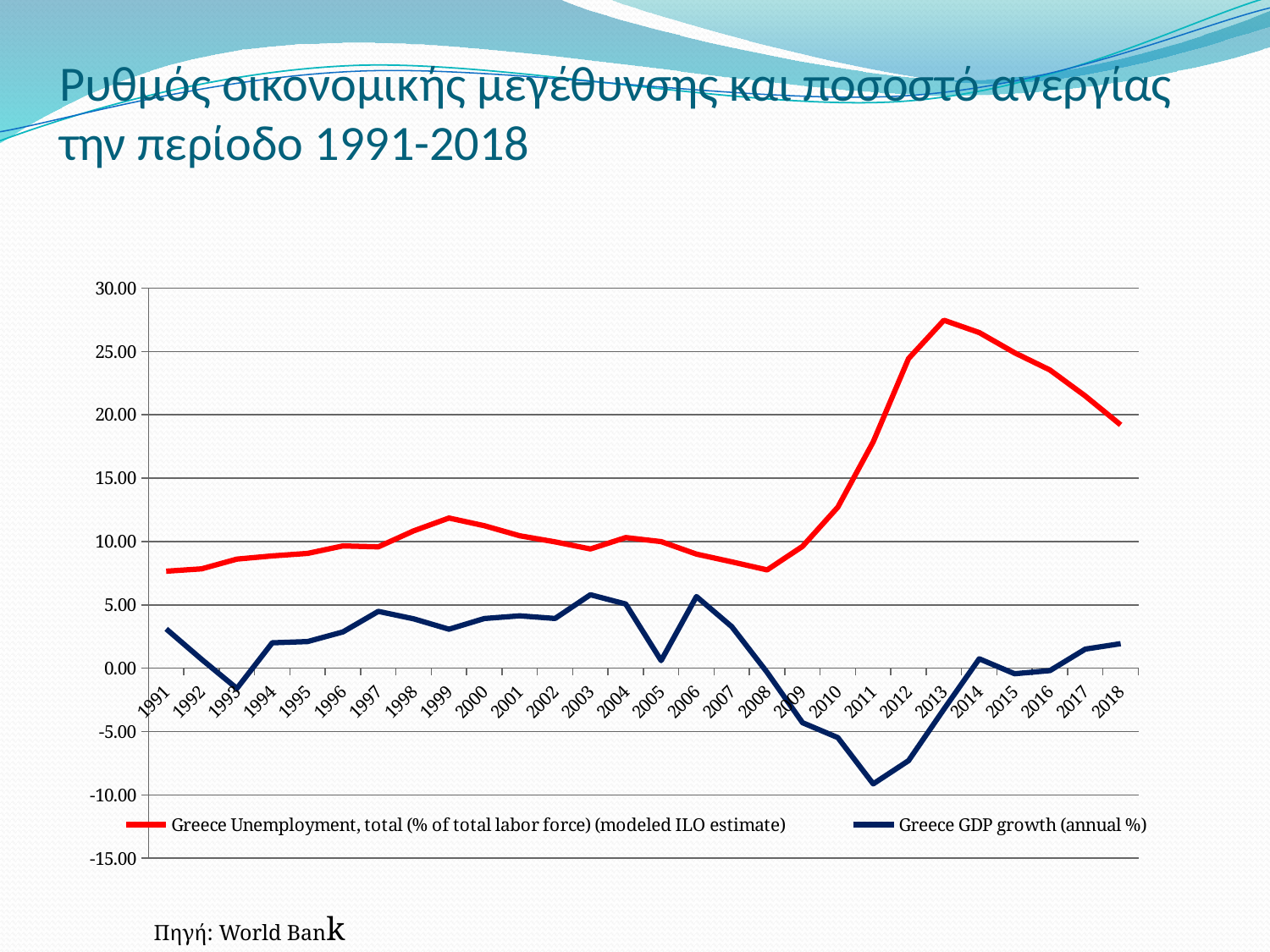
Is the Greece GDP growth value for 2003 greater or less than 5.00? greater Is the Greece Unemployment value for 2013 greater or less than 25.00? greater What kind of chart is shown on the slide? line chart How many years are plotted along the x axis? 28 Is the Greece GDP growth value for 2011 greater or less than -5.00? less Which is larger, the Greece Unemployment value for 2013 or for 2018? 2013 How many series does the legend list? 2 In which year does the Greece Unemployment series reach its highest value? 2013 Does the Greece Unemployment series rise or fall from 2013 to 2018? fall Which series is drawn in red? Greece Unemployment, total (% of total labor force) (modeled ILO estimate) In which year does the Greece GDP growth series reach its lowest value? 2011